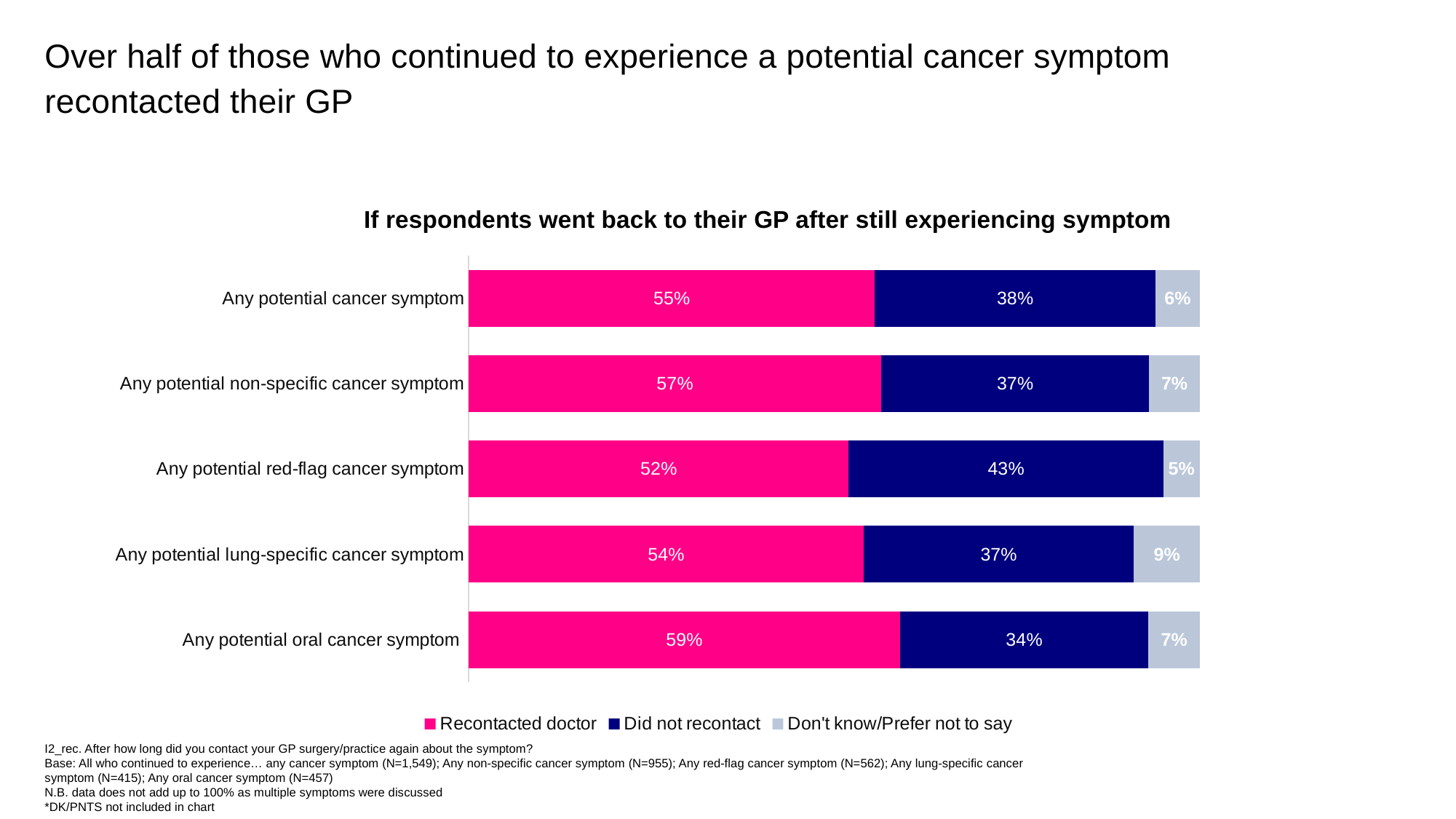
How many series does the legend list? 3 What percentage of respondents with any potential oral cancer symptom recontacted their doctor? 59% What is the title of the chart? If respondents went back to their GP after still experiencing symptom What type of chart is shown on the slide? Stacked bar chart Which is larger: the 'Did not recontact' value for any potential red-flag cancer symptom or for any potential oral cancer symptom? Any potential red-flag cancer symptom What is the 'Don't know/Prefer not to say' value for any potential lung-specific cancer symptom? 9% What is the difference between the 'Recontacted doctor' and 'Did not recontact' percentages for any potential cancer symptom? 17 percentage points How many symptom categories are shown in the chart? 5 Which category has the highest percentage of respondents who recontacted their doctor? Any potential oral cancer symptom Which category has the lowest percentage of respondents who recontacted their doctor? Any potential red-flag cancer symptom What is the total of the three segments for the any potential lung-specific cancer symptom bar? 100% What percentage of respondents with any potential red-flag cancer symptom did not recontact their GP? 43%